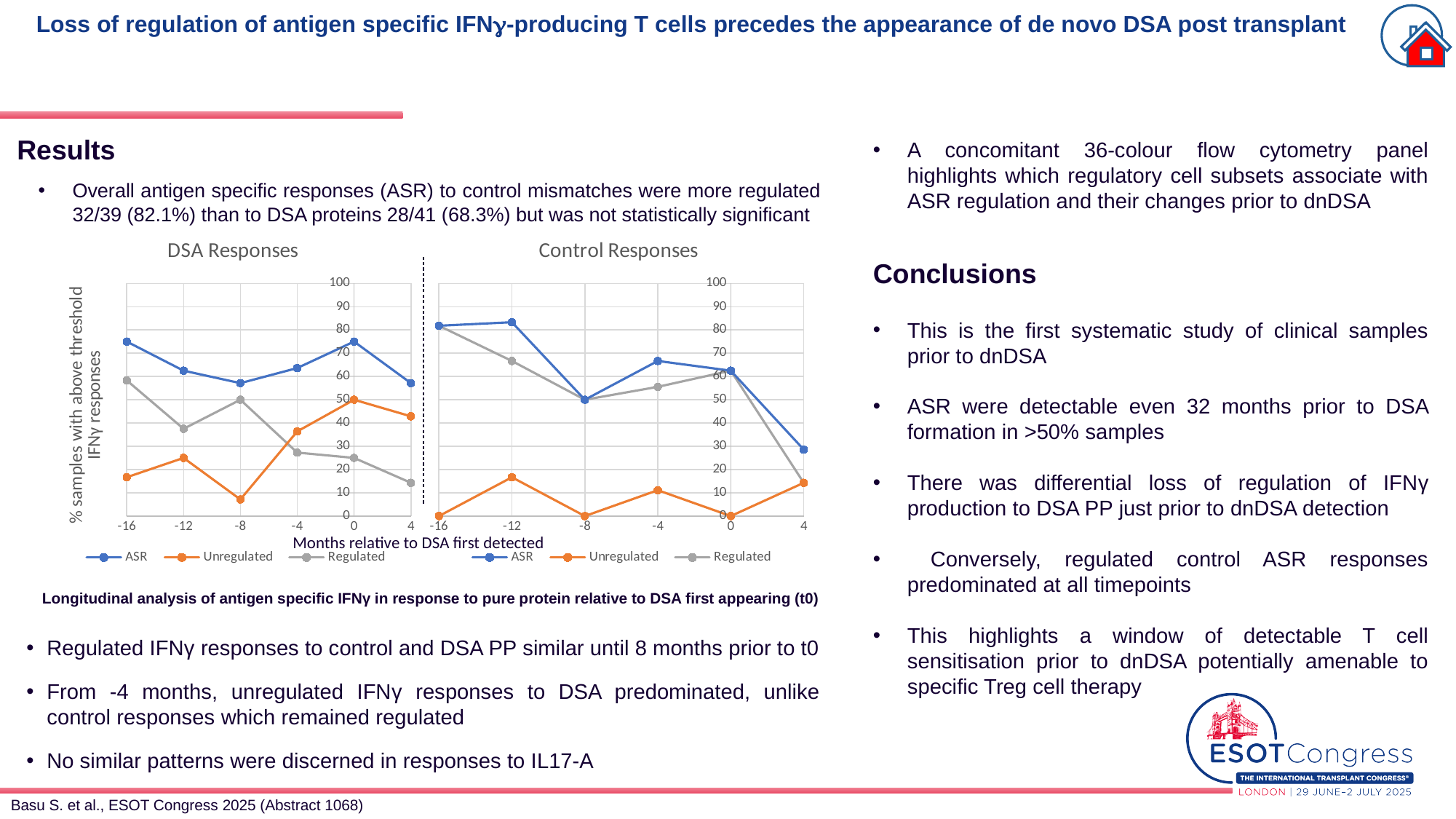
In the DSA Responses chart, is the ASR value at -16 months greater or less than 70? greater In the Control Responses chart, which series has the lowest value at -8 months? Unregulated In the Control Responses chart, is the Regulated value at -16 months greater or less than 70? greater What kind of chart is the DSA Responses chart? line chart In the Control Responses chart, is the ASR value at 4 months greater or less than 40? less How many series does the legend of the Control Responses chart list? 3 In the DSA Responses chart, at 0 months, which is larger: Unregulated or Regulated? Unregulated In the DSA Responses chart, which series has the highest value at -16 months? ASR How many time points are plotted along the x axis of the DSA Responses chart? 6 What is the x-axis title shared by the two charts? Months relative to DSA first detected In the Control Responses chart, does the Regulated series rise or fall from 0 to 4 months? fall